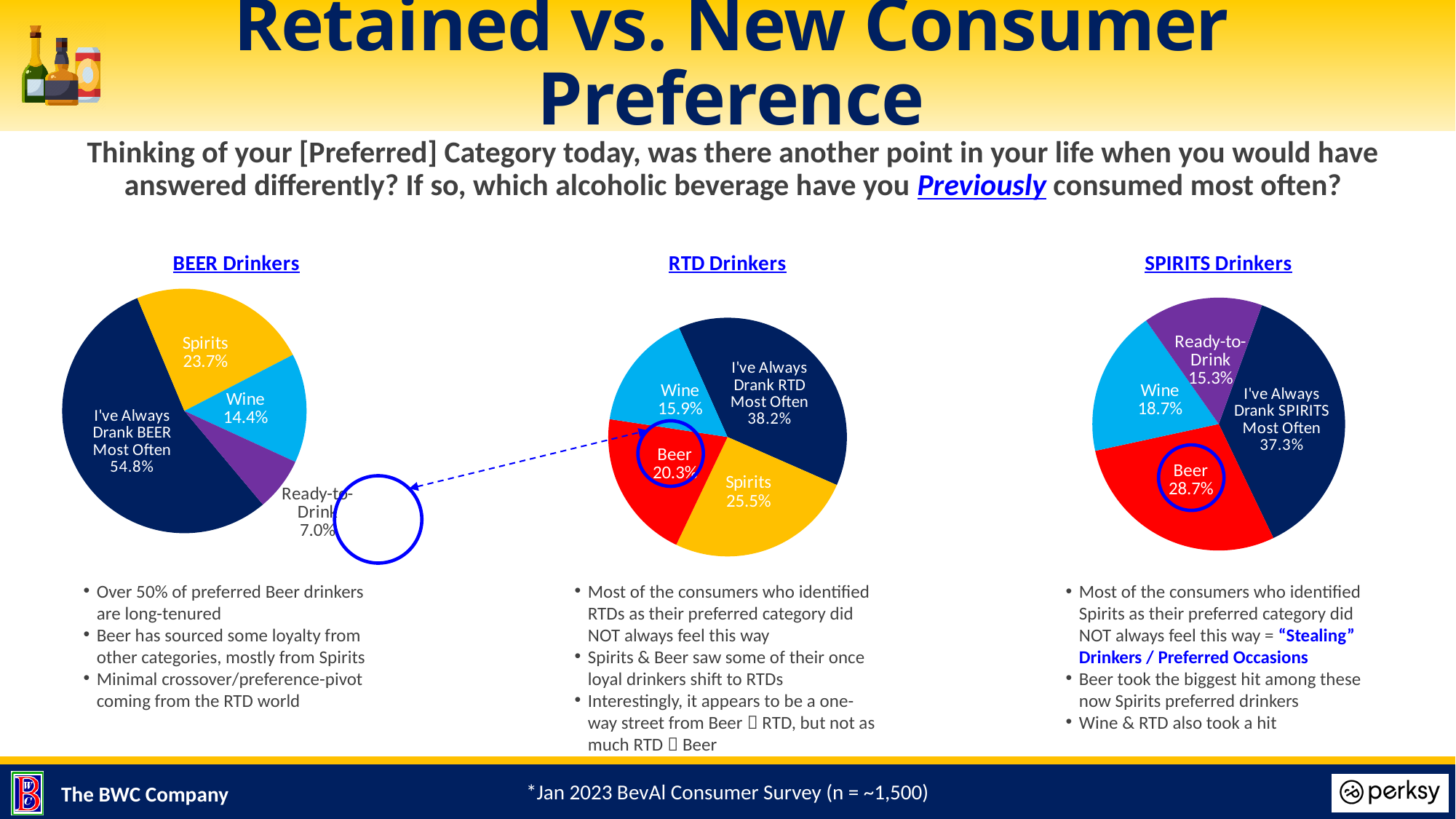
In the BEER Drinkers chart, what share of respondents said they have always drunk beer most often? 54.8% What type of chart is used for the RTD Drinkers data? Pie chart How many slices does the BEER Drinkers pie chart have? 4 In the SPIRITS Drinkers chart, what is the difference between the 'I've Always Drank SPIRITS Most Often' slice and the Beer slice? 8.6% In the RTD Drinkers chart, what percentage previously consumed Beer most often? 20.3% How many pie charts are shown on the slide? 3 In the SPIRITS Drinkers chart, which is larger, the Wine slice or the Ready-to-Drink slice? Wine In the RTD Drinkers chart, which category has the largest slice? I've Always Drank RTD Most Often In the RTD Drinkers chart, what is the difference between the Spirits and Wine slices? 9.6% In the BEER Drinkers chart, which category has the smallest slice? Ready-to-Drink In the BEER Drinkers chart, what percentage previously consumed Spirits most often? 23.7% In the SPIRITS Drinkers chart, what percentage previously consumed Beer most often? 28.7%